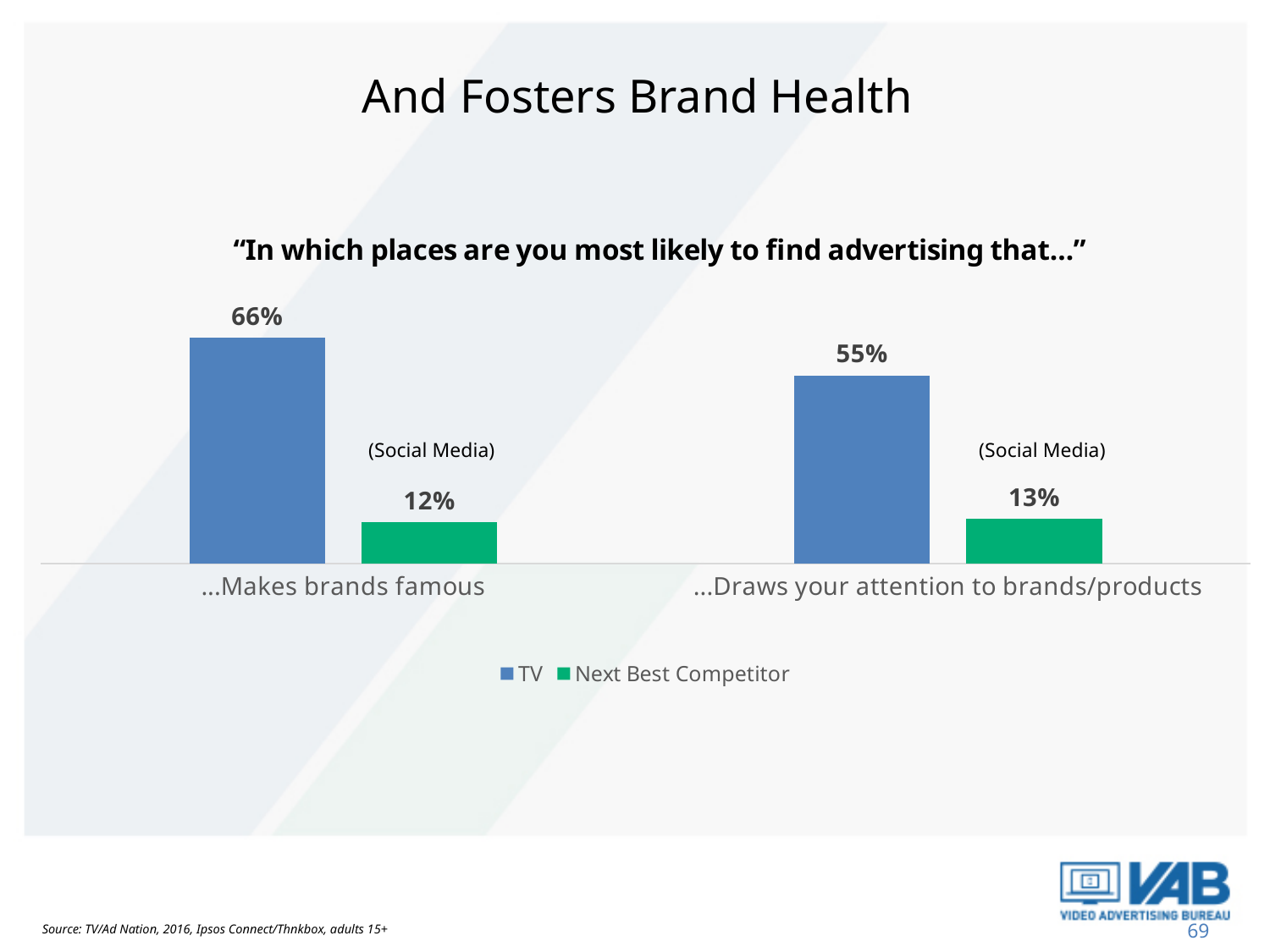
Which is larger: TV for "...Makes brands famous" or TV for "...Draws your attention to brands/products"? TV for ...Makes brands famous What is the difference between TV and Next Best Competitor in the "...Draws your attention to brands/products" category? 42 percentage points Which bar has the lowest value on the chart? Next Best Competitor, ...Makes brands famous (12%) How many categories are shown on the x axis? 2 How many series does the legend list? 2 Which bar has the highest value on the chart? TV, ...Makes brands famous (66%) What kind of chart is shown on the slide? Bar chart What is the difference between TV and Next Best Competitor in the "...Makes brands famous" category? 54 percentage points What is the value for Next Best Competitor in the "...Makes brands famous" category? 12% What is the value for TV in the "...Makes brands famous" category? 66% What is the value for Next Best Competitor in the "...Draws your attention to brands/products" category? 13% What is the value for TV in the "...Draws your attention to brands/products" category? 55%